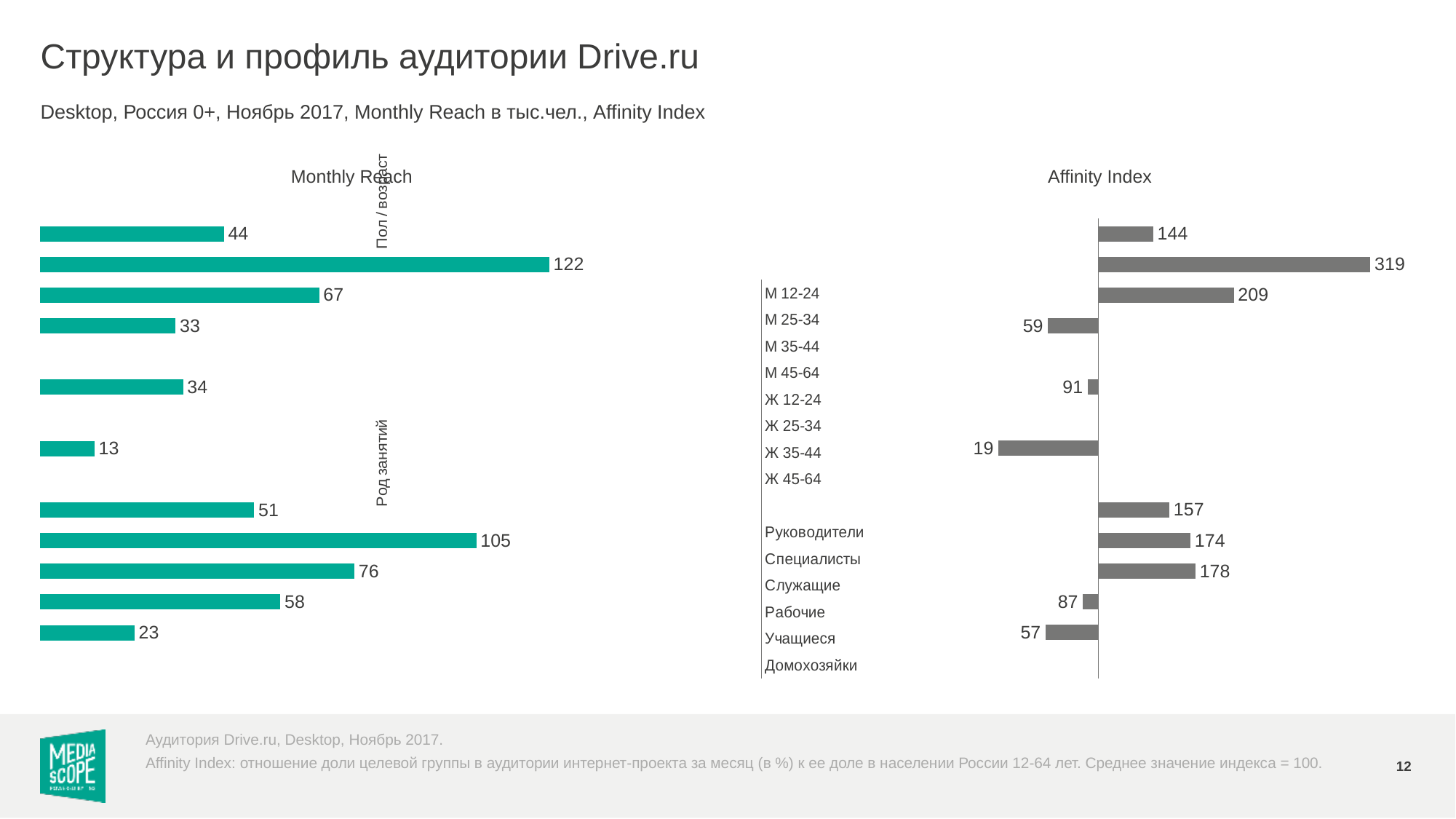
In the Monthly Reach chart, what is the highest value shown? 122 What kind of chart is the Monthly Reach chart? bar chart In the Affinity Index chart, what is the value of the bottom bar? 57 What colour are the bars in the Affinity Index chart? grey In the Monthly Reach chart, what is the value of the topmost bar? 44 In the Monthly Reach chart, what is the value of the bottom bar? 23 In the Affinity Index chart, what is the lowest value shown? 19 In the Affinity Index chart, what is the value of the topmost bar? 144 In the Affinity Index chart, what is the difference between the highest value (319) and the lowest value (19)? 300 In the Affinity Index chart, what is the highest value shown? 319 How many bars are plotted in the Monthly Reach chart? 11 In the Monthly Reach chart, what is the lowest value shown? 13